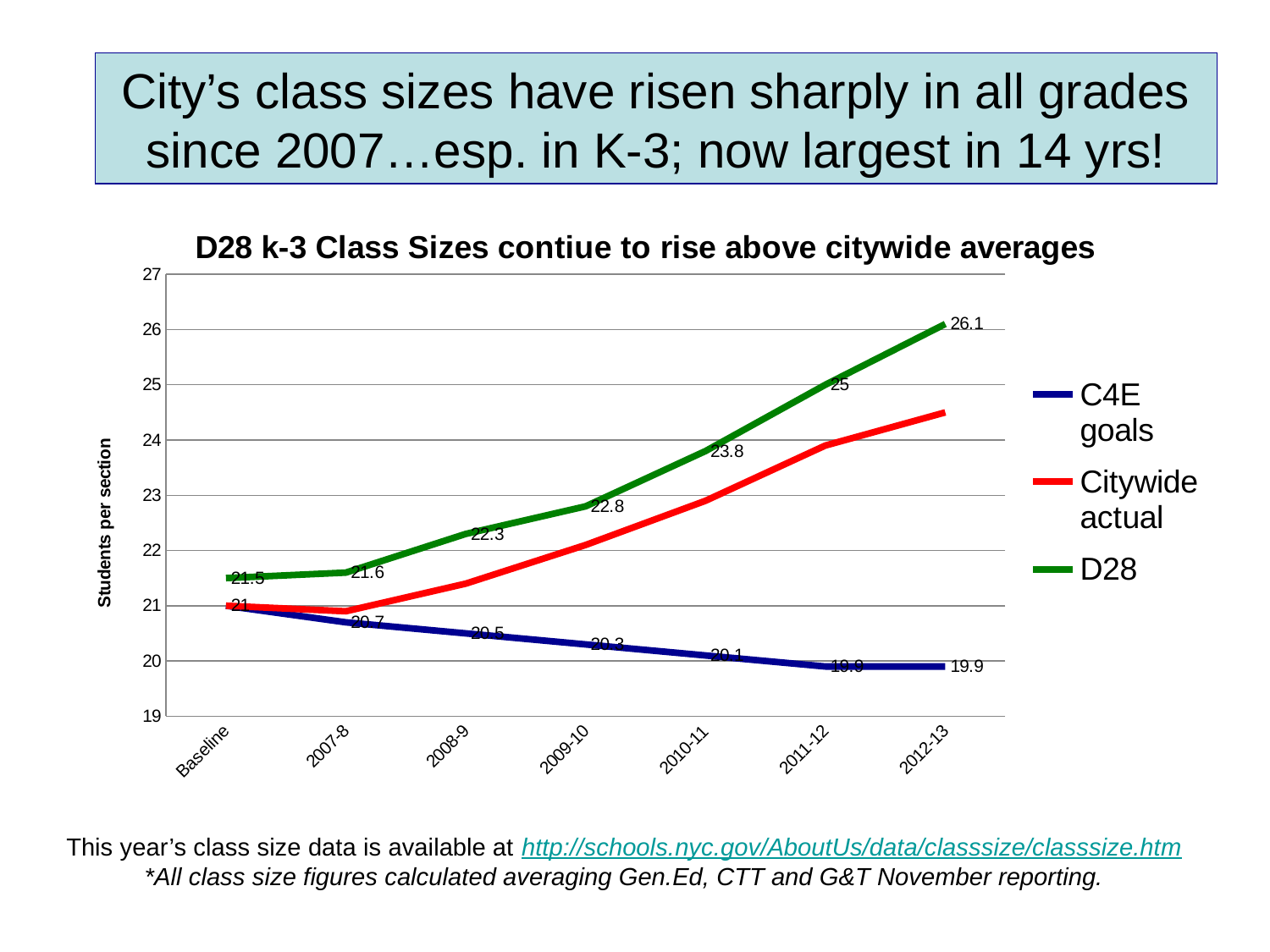
In which year does the D28 series reach its highest value? 2012-13 Is the Citywide actual value for 2012-13 greater or less than 24? greater What is the C4E goals value for 2012-13? 19.9 How many series does the legend list? 3 How many points are plotted along the x axis for each series? 7 What kind of chart is shown on the slide? Line chart Does the D28 series rise or fall from Baseline to 2012-13? Rise What is the D28 value for 2010-11? 23.8 By how much did the D28 value increase from Baseline to 2012-13? 4.6 What is the D28 value for 2012-13? 26.1 In 2012-13, which is larger: the D28 value or the C4E goals value? D28 What is the D28 value at Baseline? 21.5